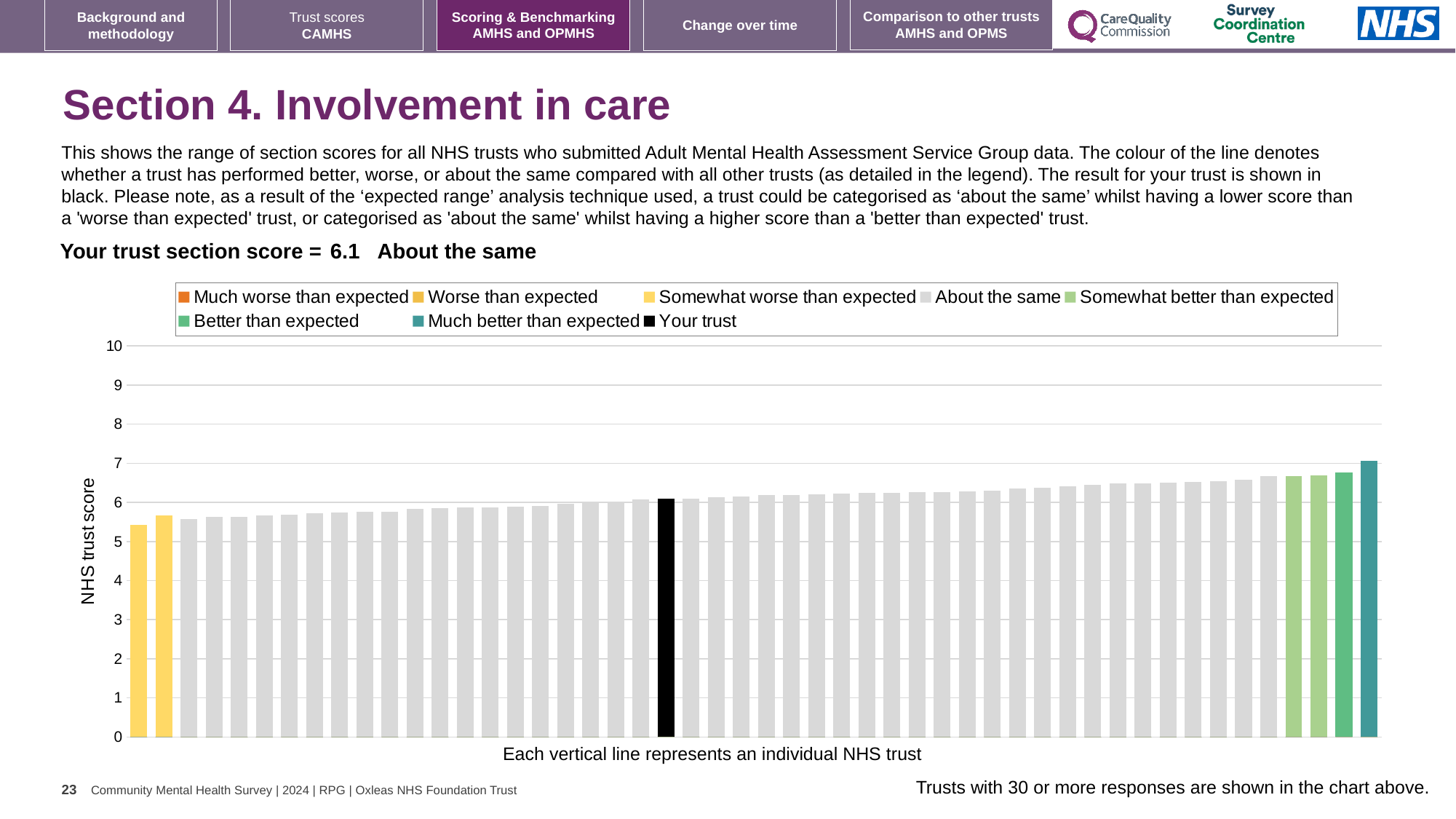
Is the value of the black bar (your trust) greater or less than 5? greater How many bars are coloured yellow (Somewhat worse than expected)? 2 How many bars are coloured black (Your trust)? 1 Is the value of the leftmost bar greater or less than 6? less Which category is your trust placed in for this section? About the same What is the section score for your trust shown on the slide? 6.1 According to the legend, which category does the teal colour represent? Much better than expected What is the label on the vertical axis of the chart? NHS trust score What kind of chart is shown on the slide? bar chart How many entries does the chart legend list? 8 Is the value of the rightmost bar greater or less than 6? greater Do the bar values rise or fall from left to right across the chart? rise